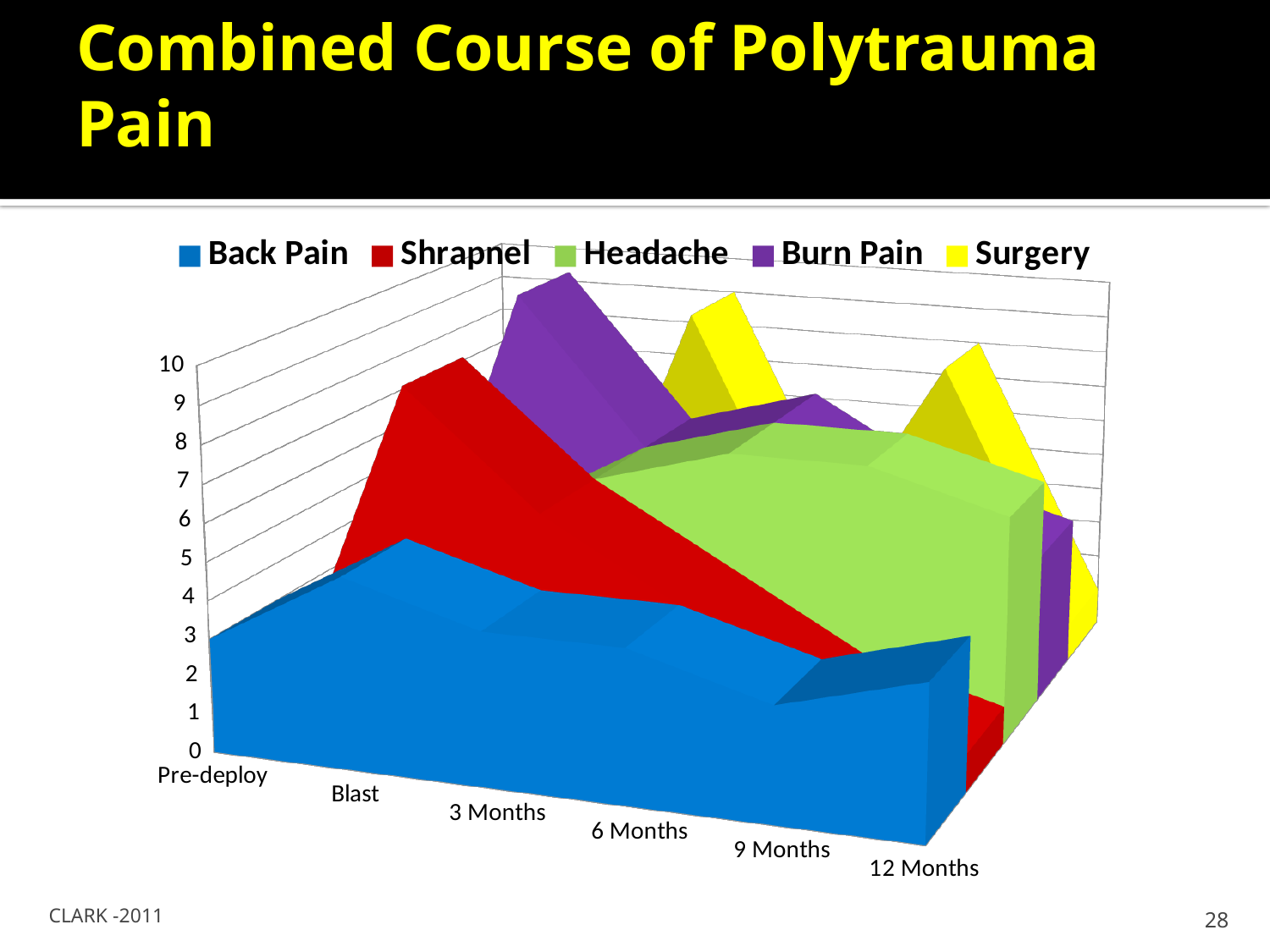
How many series does the legend list? 5 What is the maximum value shown on the vertical axis? 10 Which colour represents the Surgery series in the legend? yellow What kind of chart is shown on the slide? area chart Is the Back Pain value at Pre-deploy greater or less than 5? less What is the title of the slide containing the chart? Combined Course of Polytrauma Pain Is the Back Pain value at Blast greater or less than 3? greater How many categories are shown along the x axis? 6 Does the Back Pain series rise or fall from Pre-deploy to Blast? rise Which is larger for Back Pain: the value at Pre-deploy or the value at Blast? Blast